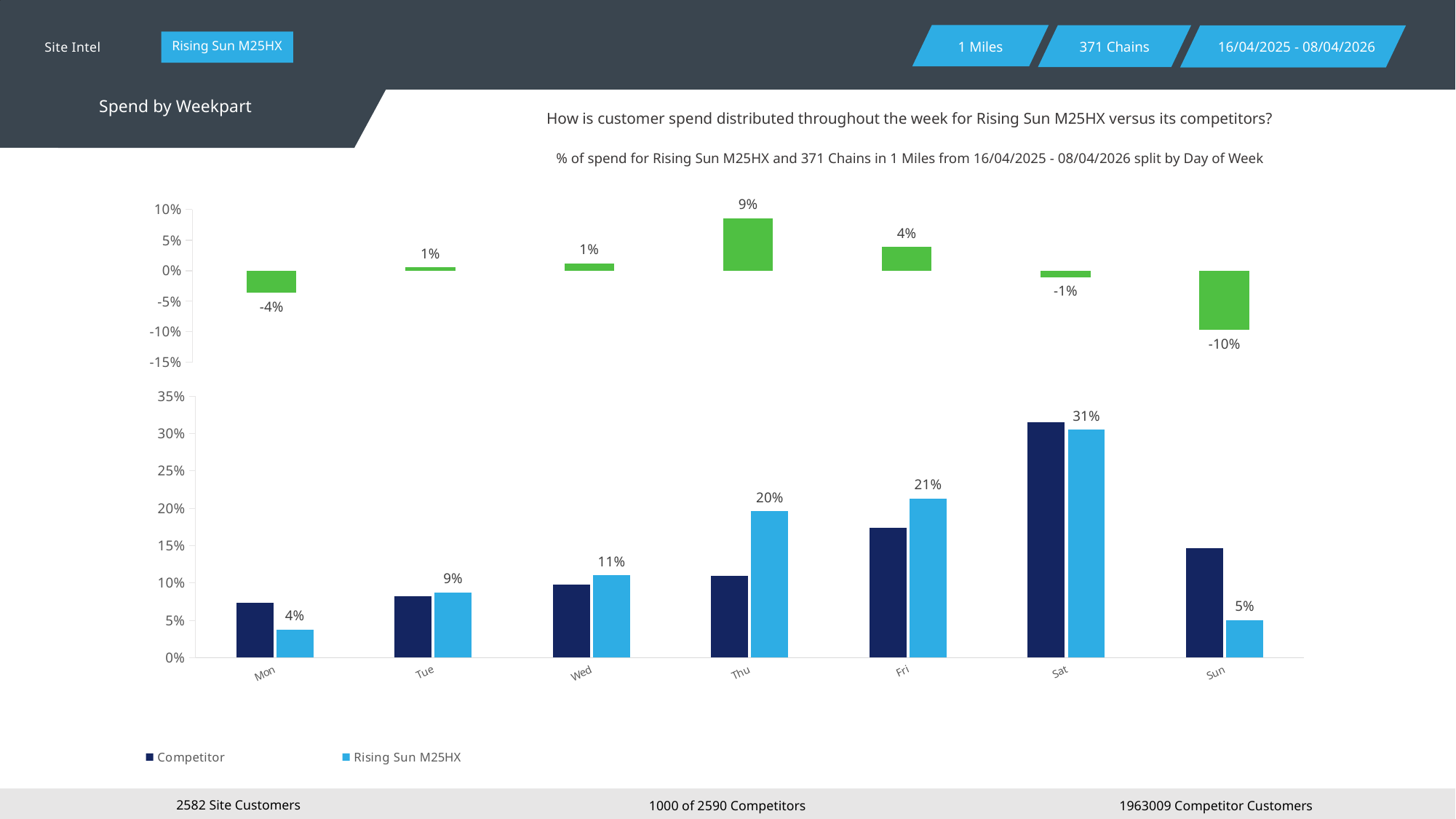
What kind of chart is the bottom chart? bar chart In the top chart, which day has the lowest value? Sun In the bottom chart, on which day is the Rising Sun M25HX value lowest? Mon In the top chart, which day has the highest value? Thu How many days of the week are shown on the x axis of the bottom chart? 7 In the bottom chart, what is the value for Rising Sun M25HX on Thu? 20% In the top chart, what is the value shown for Sun? -10% How many series does the legend of the bottom chart list? 2 In the bottom chart, on Sun, which series has the larger value: Competitor or Rising Sun M25HX? Competitor In the bottom chart, on which day is the Rising Sun M25HX value highest? Sat In the bottom chart, is the Competitor value for Fri greater or less than 15%? greater In the bottom chart, what is the difference between the Rising Sun M25HX values for Sat and Sun? 26%